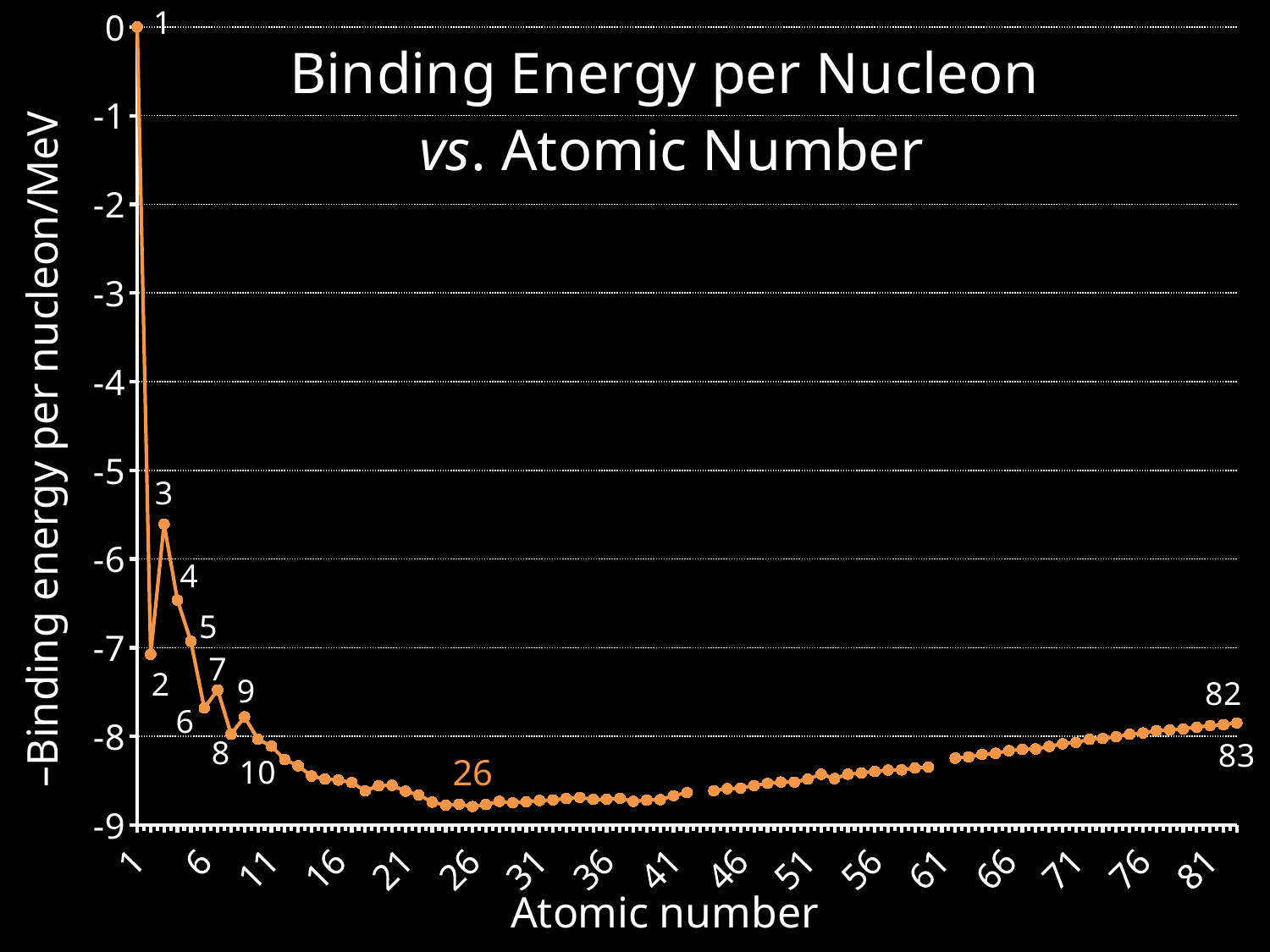
Is the value for atomic number 3 greater or less than -5? less Which atomic number has the highest plotted value? 1 Is the value for atomic number 4 greater or less than -6? less What kind of chart is shown on the slide? line chart Is the value for atomic number 26 greater or less than -8? less Which has the higher plotted value, atomic number 3 or atomic number 4? atomic number 3 Do the plotted values rise or fall as the atomic number increases from 26 to 83? rise What is the plotted value for atomic number 1? 0 Which atomic number has the lowest plotted value? 26 What is the title of the chart? Binding Energy per Nucleon vs. Atomic Number What is the label of the x axis? Atomic number